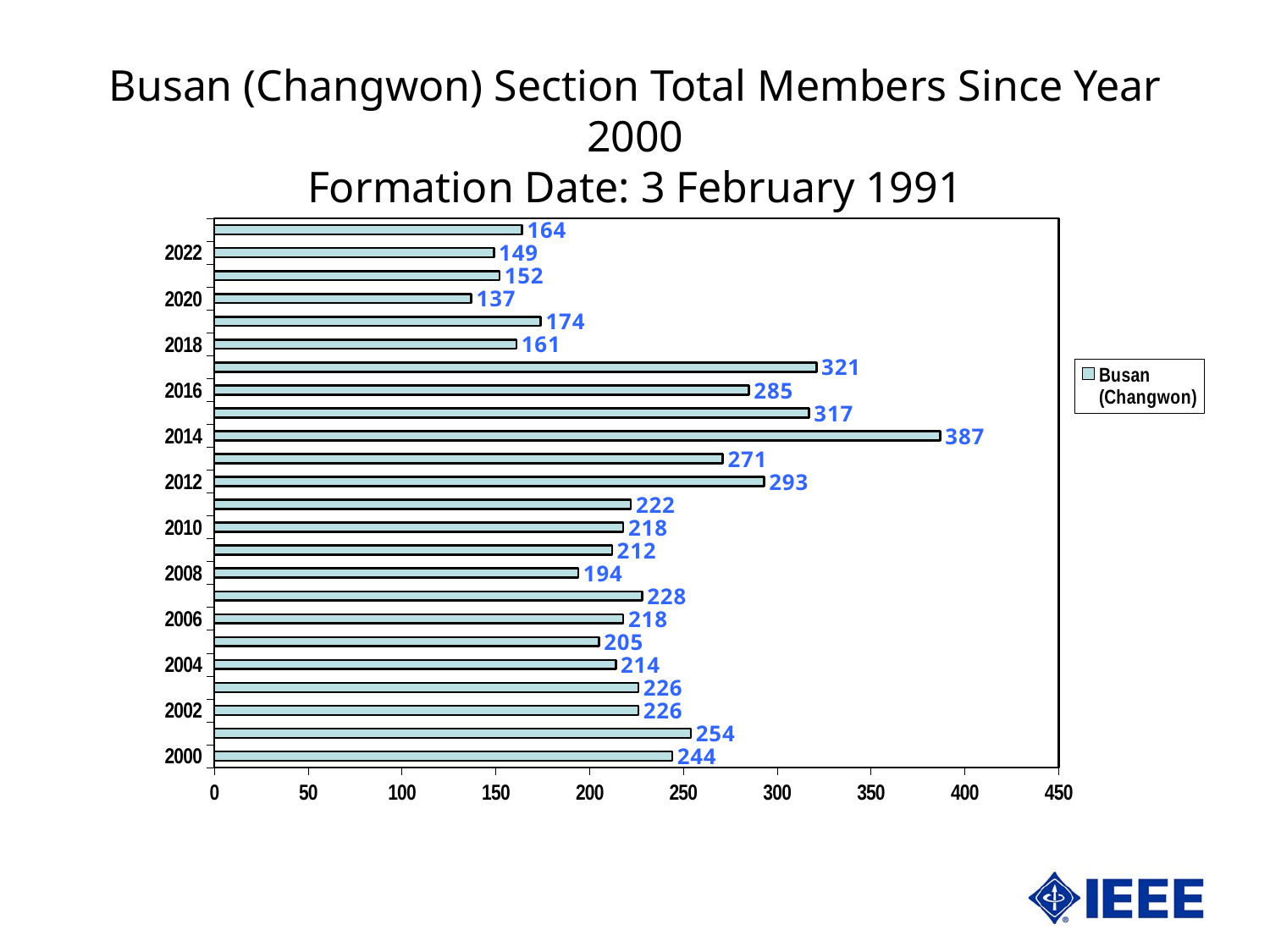
What series name does the legend show? Busan (Changwon) How many bars are plotted in the chart? 24 Which year has the lowest value? 2020 What kind of chart is shown? bar chart Is the value for 2016 greater or less than 250? greater What is the value for 2020? 137 What is the value for 2000? 244 What is the value for 2012? 293 Which year has the highest value? 2014 What is the difference between the values for 2014 and 2016? 102 Which is larger, the value for 2018 or the value for 2008? 2008 What is the value for 2014? 387